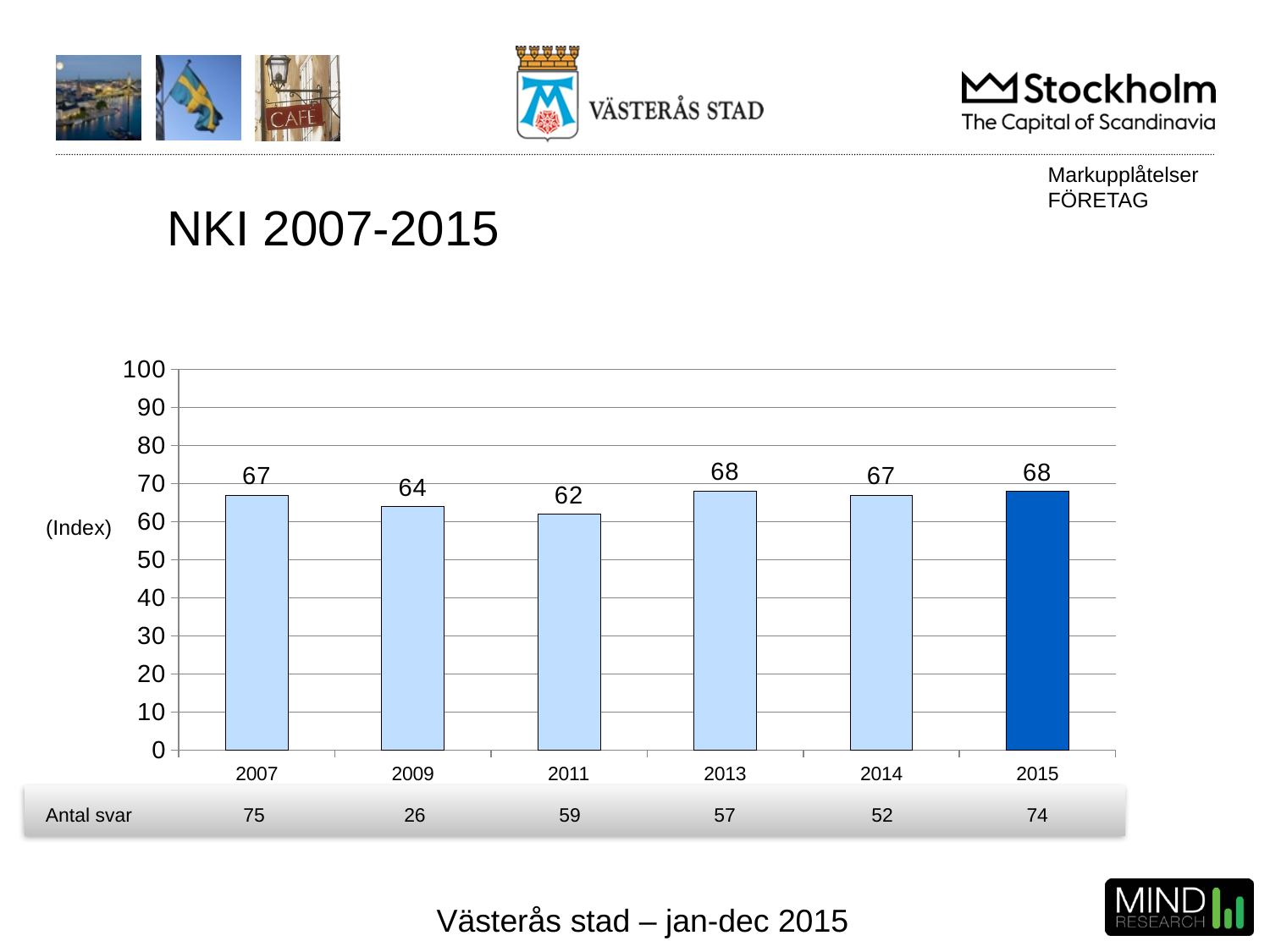
What is the difference between the NKI index values for 2007 and 2009? 3 How many years are shown on the x axis of the chart? 6 Which year has the lowest NKI index value? 2011 Does the NKI index value rise or fall from 2011 to 2013? rise What is the NKI index value for 2011? 62 What is the NKI index value for 2015? 68 Is the NKI index value for 2014 greater or less than 50? greater Which is larger, the NKI index value for 2009 or for 2011? 2009 What is the title of the chart? NKI 2007-2015 What kind of chart is shown on the slide? bar chart What is the difference between the NKI index values for 2013 and 2011? 6 What is the NKI index value for 2009? 64